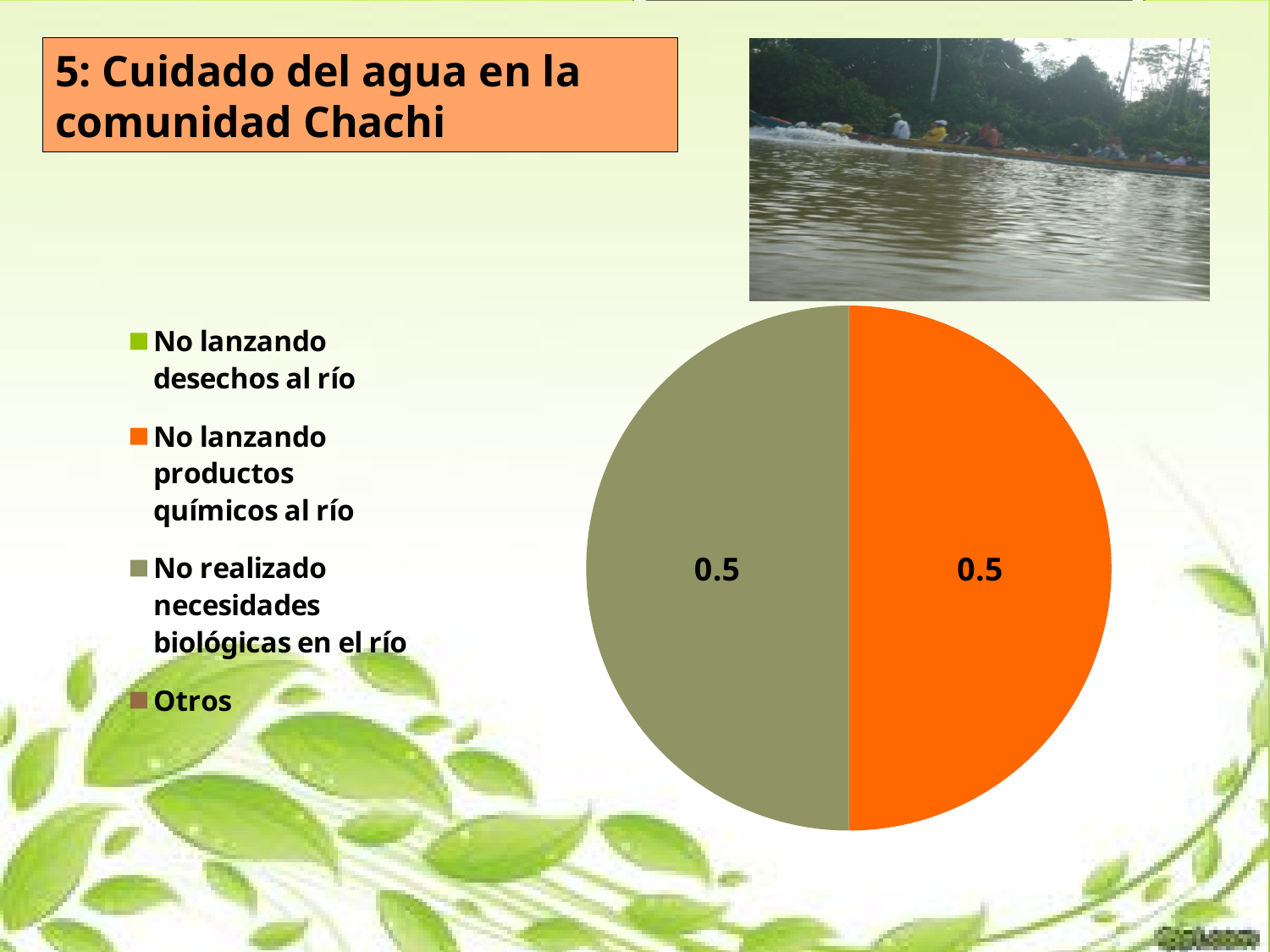
What share of the pie does the slice "No lanzando productos químicos al río" take? 0.5 What is the total of the two labelled slices in the pie chart? 1 Which legend entry corresponds to the orange slice of the pie? No lanzando productos químicos al río How many entries does the legend of the pie chart list? 4 What kind of chart is shown on the slide? pie chart How many slices are visible in the pie chart? 2 What value is shown for the slice "No lanzando productos químicos al río"? 0.5 What value is shown for the slice "No realizado necesidades biológicas en el río"? 0.5 What is the difference between the values of the orange slice and the olive slice? 0 What colour is the legend marker for "Otros"? brown